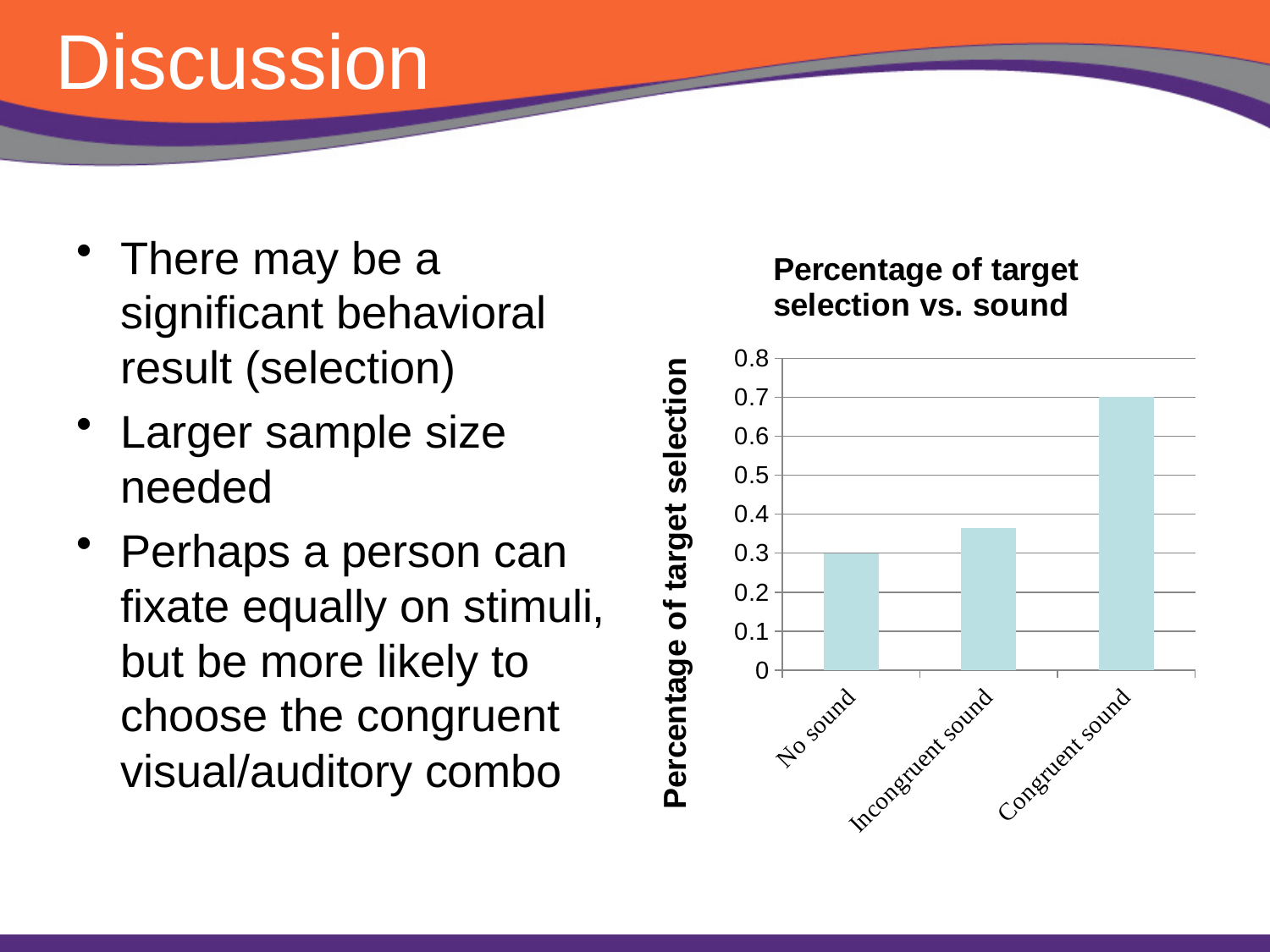
What type of chart is shown on the slide? bar chart Is the value for Incongruent sound greater or less than 0.4? less Which category has the lowest percentage of target selection? No sound Is the value for Incongruent sound greater or less than 0.3? greater Do the values rise or fall from left to right along the x axis? rise What is the difference between the values for Congruent sound and No sound? 0.4 What is the percentage of target selection for No sound? 0.3 What is the percentage of target selection for Congruent sound? 0.7 Which category has the highest percentage of target selection? Congruent sound How many categories are shown on the x axis of the chart? 3 Which is larger, the value for Incongruent sound or the value for Congruent sound? Congruent sound What is the title of the chart? Percentage of target selection vs. sound